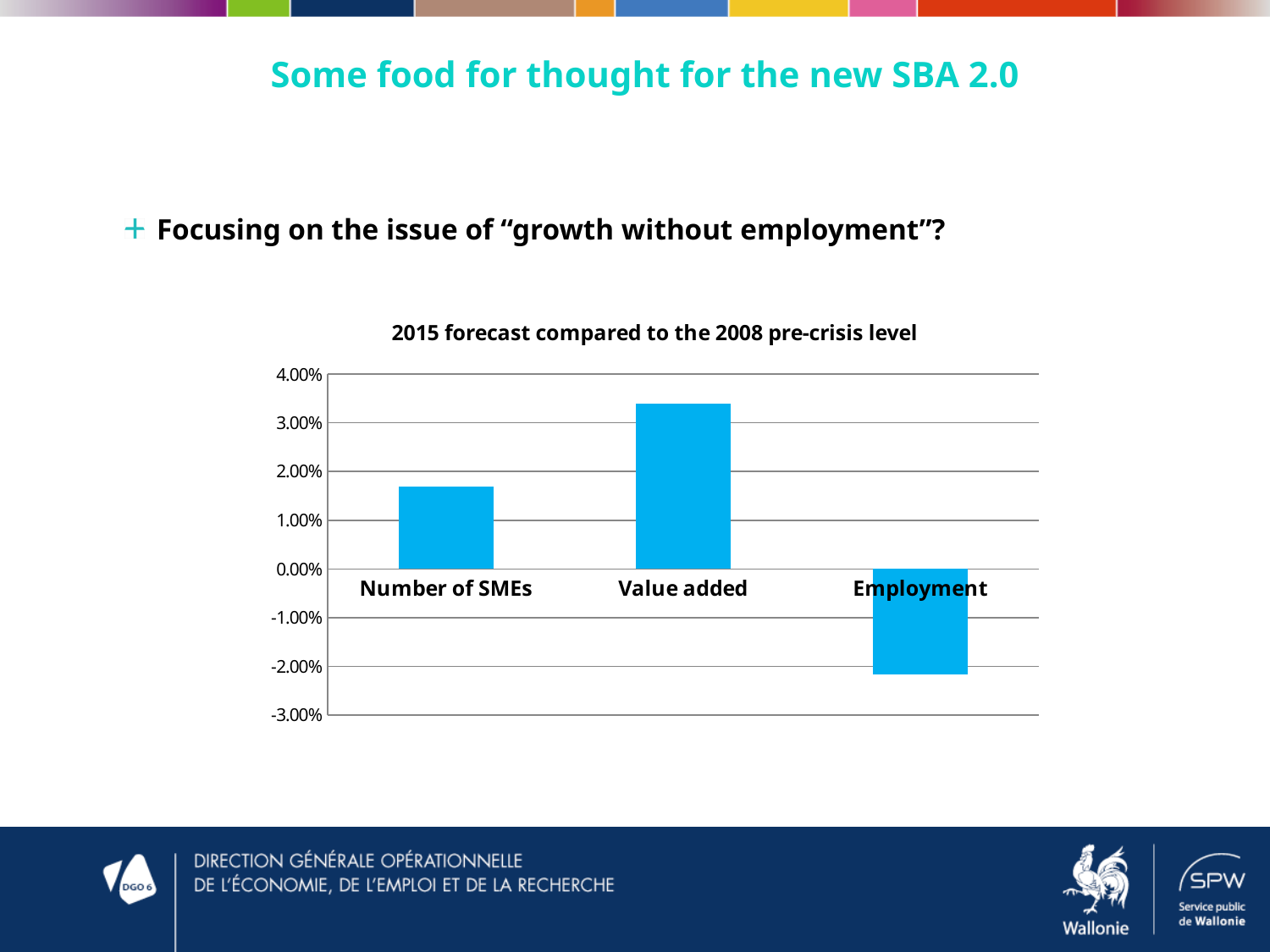
Is the value for Number of SMEs greater or less than 2.00%? less Is the value for Employment greater or less than -1.00%? less Which category in the chart has a negative value? Employment How many categories are plotted in the chart? 3 What is the title of the chart? 2015 forecast compared to the 2008 pre-crisis level Which is larger, the value for Number of SMEs or the value for Employment? Number of SMEs What kind of chart is shown on the slide? bar chart Which category has the highest value in the chart? Value added Is the value for Number of SMEs greater or less than 1.00%? greater Which is larger, the value for Number of SMEs or the value for Value added? Value added Which category has the lowest value in the chart? Employment